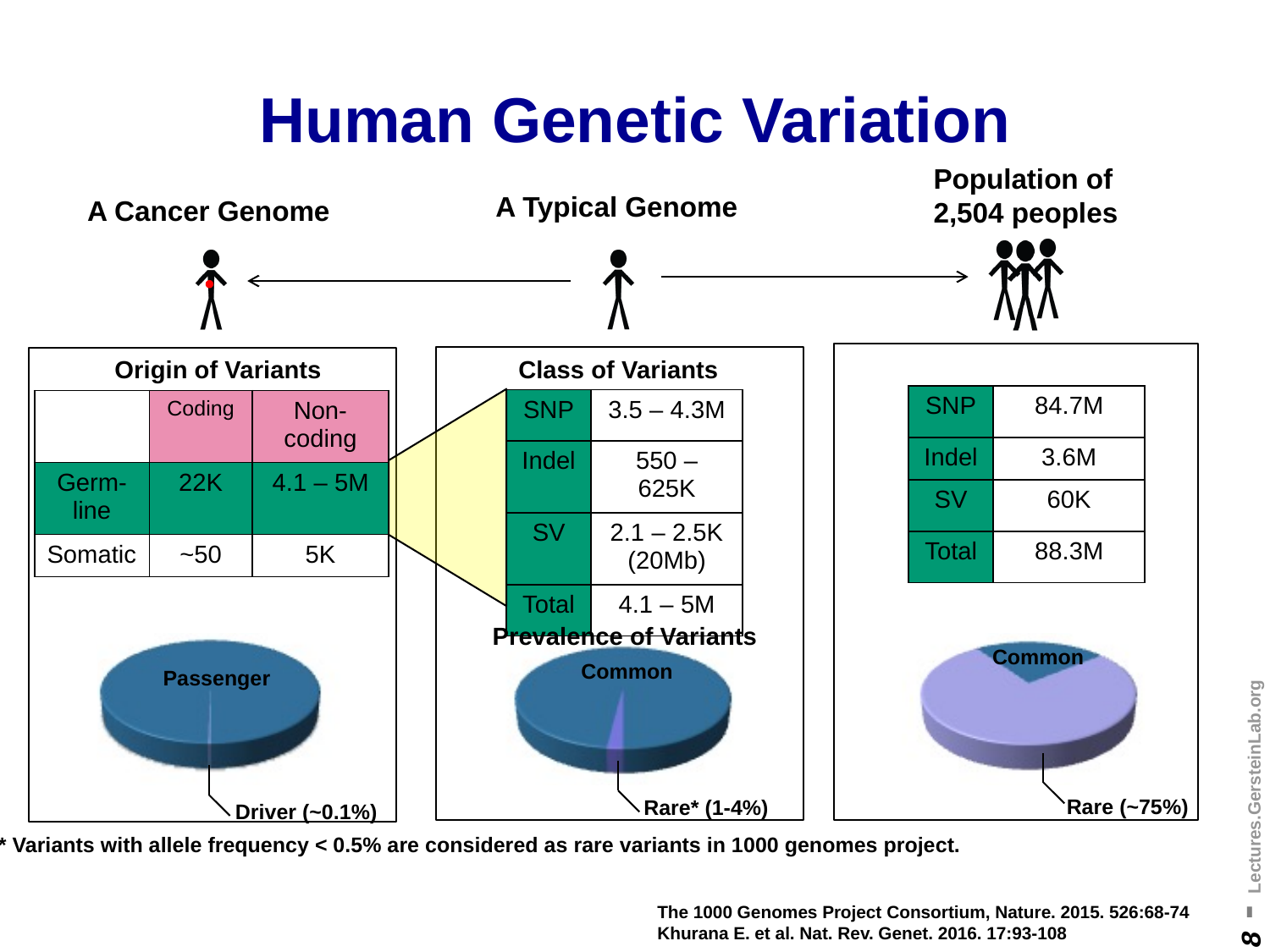
In the pie chart under 'Population of 2,504 peoples', is the Common slice greater or less than 50% of the pie? less How many pie charts are shown on the slide? 3 In the pie chart under 'A Cancer Genome', what is the label of the small slice? Driver (~0.1%) In the pie chart under 'Population of 2,504 peoples', is the Rare slice greater or less than 50% of the pie? greater How many slices does the pie chart under 'A Cancer Genome' have? 2 How many slices does the 'Prevalence of Variants' pie chart under 'A Typical Genome' have? 2 In the 'Prevalence of Variants' pie chart under 'A Typical Genome', what is the label of the small slice? Rare* (1-4%) In the 'Prevalence of Variants' pie chart under 'A Typical Genome', which slice is larger, Common or Rare? Common In the pie chart under 'A Cancer Genome', which slice is larger, Passenger or Driver? Passenger What kind of chart is shown at the bottom of the 'Population of 2,504 peoples' panel? pie chart In the pie chart under 'Population of 2,504 peoples', which slice is larger, Common or Rare? Rare What kind of chart is shown at the bottom of the 'A Cancer Genome' panel? pie chart